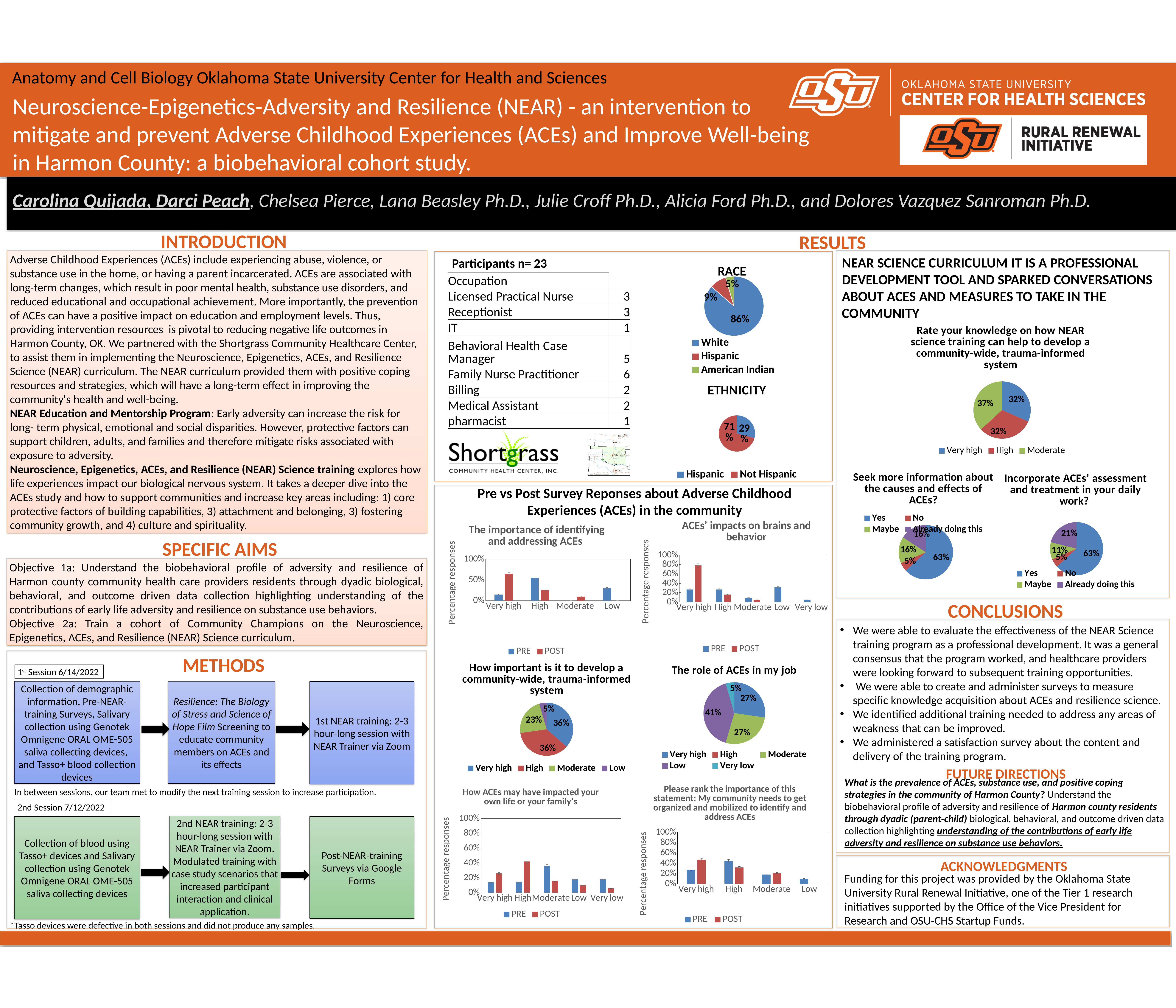
In the bar chart 'How ACEs may have impacted your own life or your family's', how many categories are shown on the x axis? 5 In the ETHNICITY pie chart, what share of participants are Not Hispanic? 71% In the bar chart 'ACEs' impacts on brains and behavior', how many series does the legend list? 2 In the pie chart 'Rate your knowledge on how NEAR science training can help to develop a community-wide, trauma-informed system', what share is Moderate? 37% In the pie chart 'Incorporate ACEs' assessment and treatment in your daily work?', what share answered Already doing this? 21% In the pie chart 'How important is it to develop a community-wide, trauma-informed system', what share is Low? 5% In the ETHNICITY pie chart, what is the difference between the Not Hispanic and Hispanic shares? 42% In the pie chart 'The role of ACEs in my job', what is the percentage of the largest slice? 41% In the bar chart 'The importance of identifying and addressing ACEs', is the POST value for Very high greater or less than 50%? greater In the pie chart 'Seek more information about the causes and effects of ACEs?', what share answered Yes? 63% In the RACE pie chart, which category has the smallest share? American Indian In the RACE pie chart, what percentage of participants are White? 86%